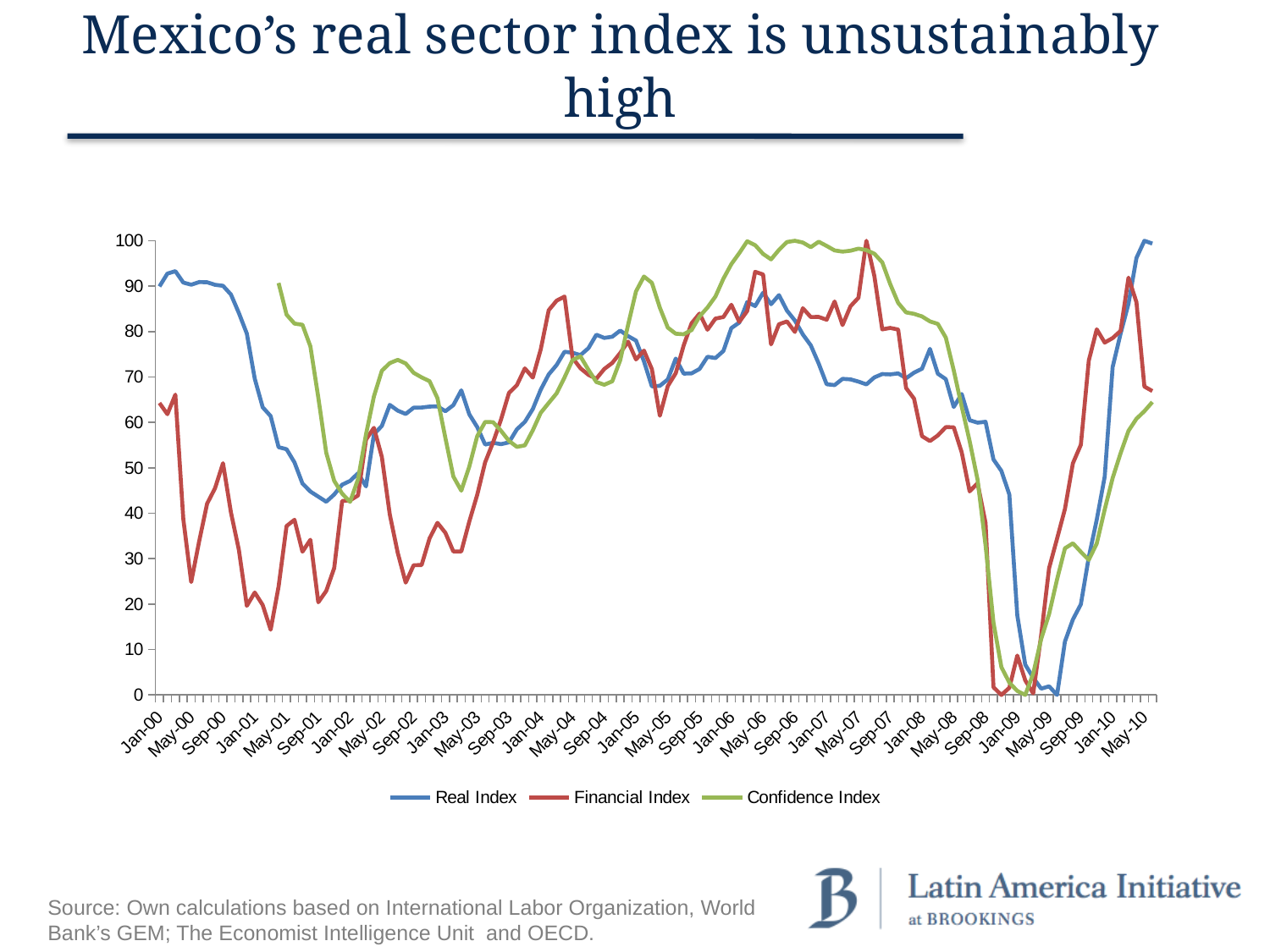
Is the value of the Financial Index at Jan-01 greater or less than 30? less What kind of chart is shown on the slide? Line chart At Jan-01, which is higher: the Real Index or the Financial Index? Real Index Which colour is used for the Real Index line? Blue At Sep-09, which is higher: the Financial Index or the Real Index? Financial Index What is the title of the slide? Mexico's real sector index is unsustainably high Is the value of the Confidence Index at May-01 greater or less than 80? greater How many series does the legend list? 3 Does the Real Index rise or fall between Sep-09 and May-10? Rise Is the value of the Real Index at Jan-00 greater or less than 80? greater